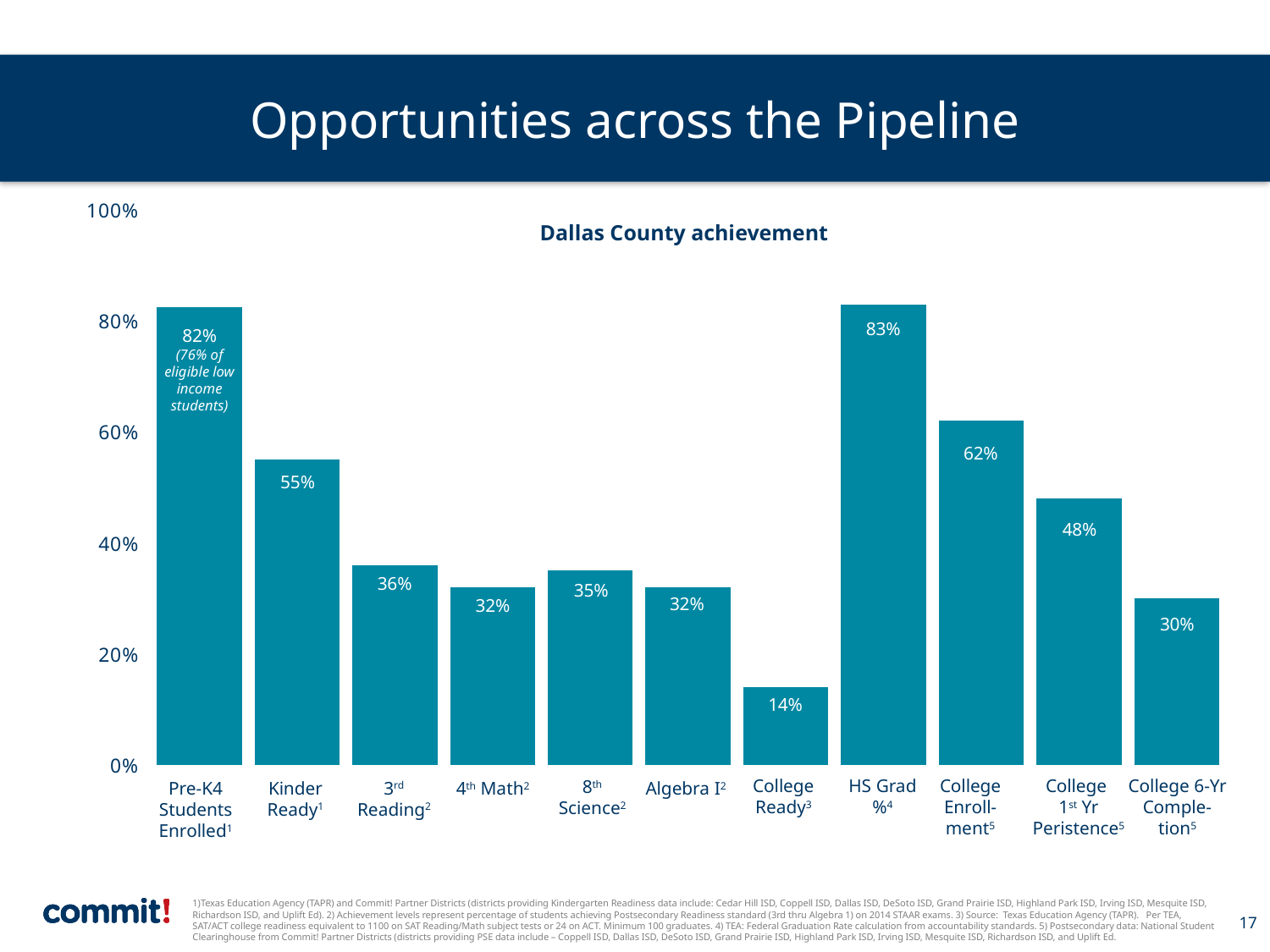
Which is larger, College 1st Yr Persistence or College 6-Yr Completion? College 1st Yr Persistence What is the difference between Kinder Ready and 3rd Reading? 19% What is the value for College 6-Yr Completion? 30% Which category has the lowest value in the chart? College Ready Which is larger, 8th Science or 4th Math? 8th Science How many categories are shown in the chart? 11 What is the value for Kinder Ready? 55% What is the value for College Ready in the Dallas County achievement chart? 14% What is the difference between HS Grad % and College Enrollment? 21% What kind of chart is shown on the slide? Bar chart What is the value for College Enrollment? 62% What is the title of the chart? Dallas County achievement